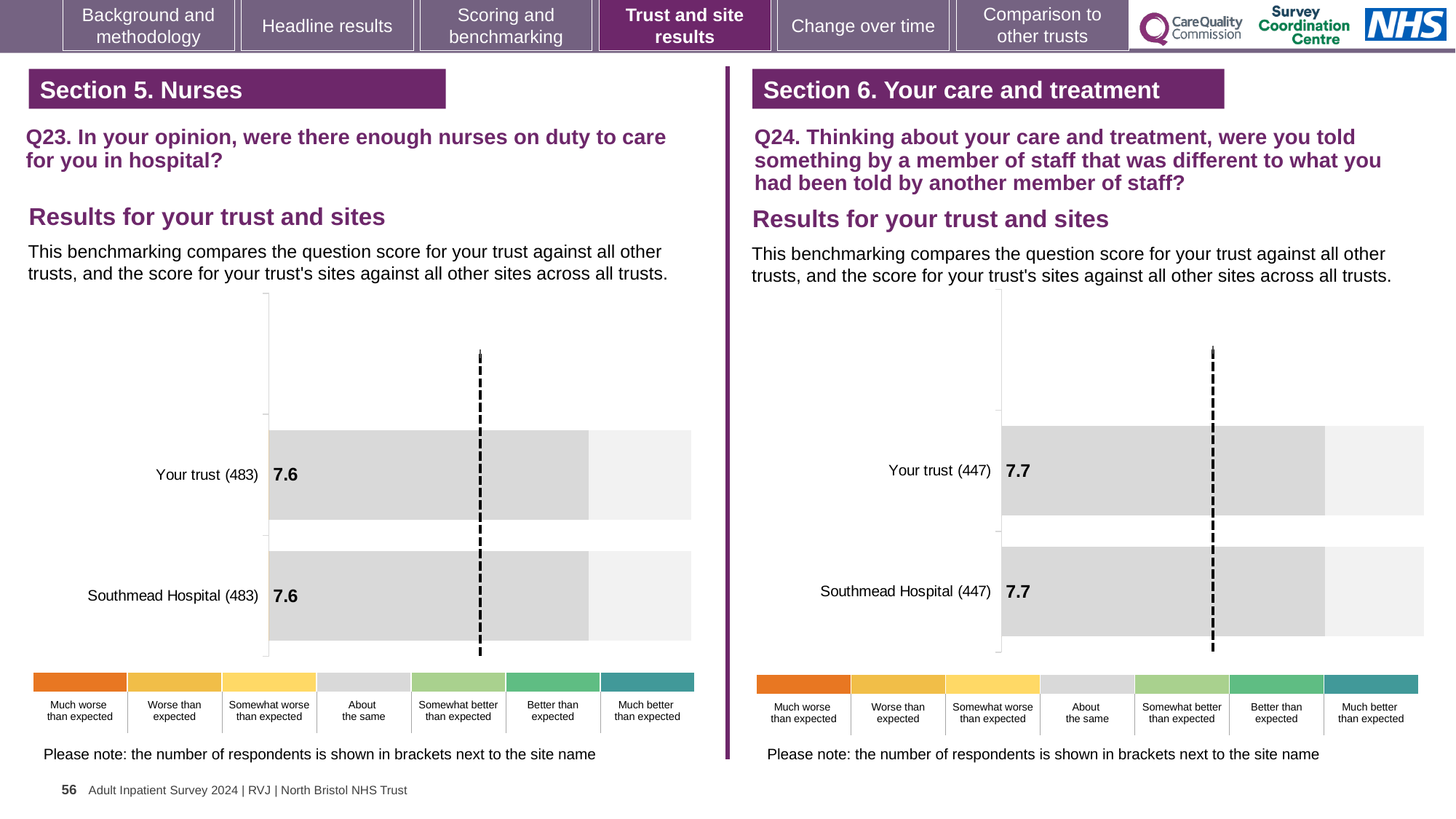
In the Q23 chart on the left, how many bars are plotted? 2 What kind of chart is the Q23 chart on the left? Bar chart In the Q24 chart on the right, how many respondents are shown in brackets next to Southmead Hospital? 447 In the Q24 chart on the right, how many bars are plotted? 2 In the Q23 chart on the left, what is the difference between the score for Your trust and the score for Southmead Hospital? 0 In the Q23 chart on the left, what is the score for Southmead Hospital? 7.6 In the Q24 chart on the right, what is the score for Southmead Hospital? 7.7 In the Q23 chart on the left, what is the score for Your trust? 7.6 In the Q23 chart on the left, how many respondents are shown in brackets next to Your trust? 483 In the Q24 chart on the right, what is the difference between the score for Your trust and the score for Southmead Hospital? 0 In the Q24 chart on the right, what is the score for Your trust? 7.7